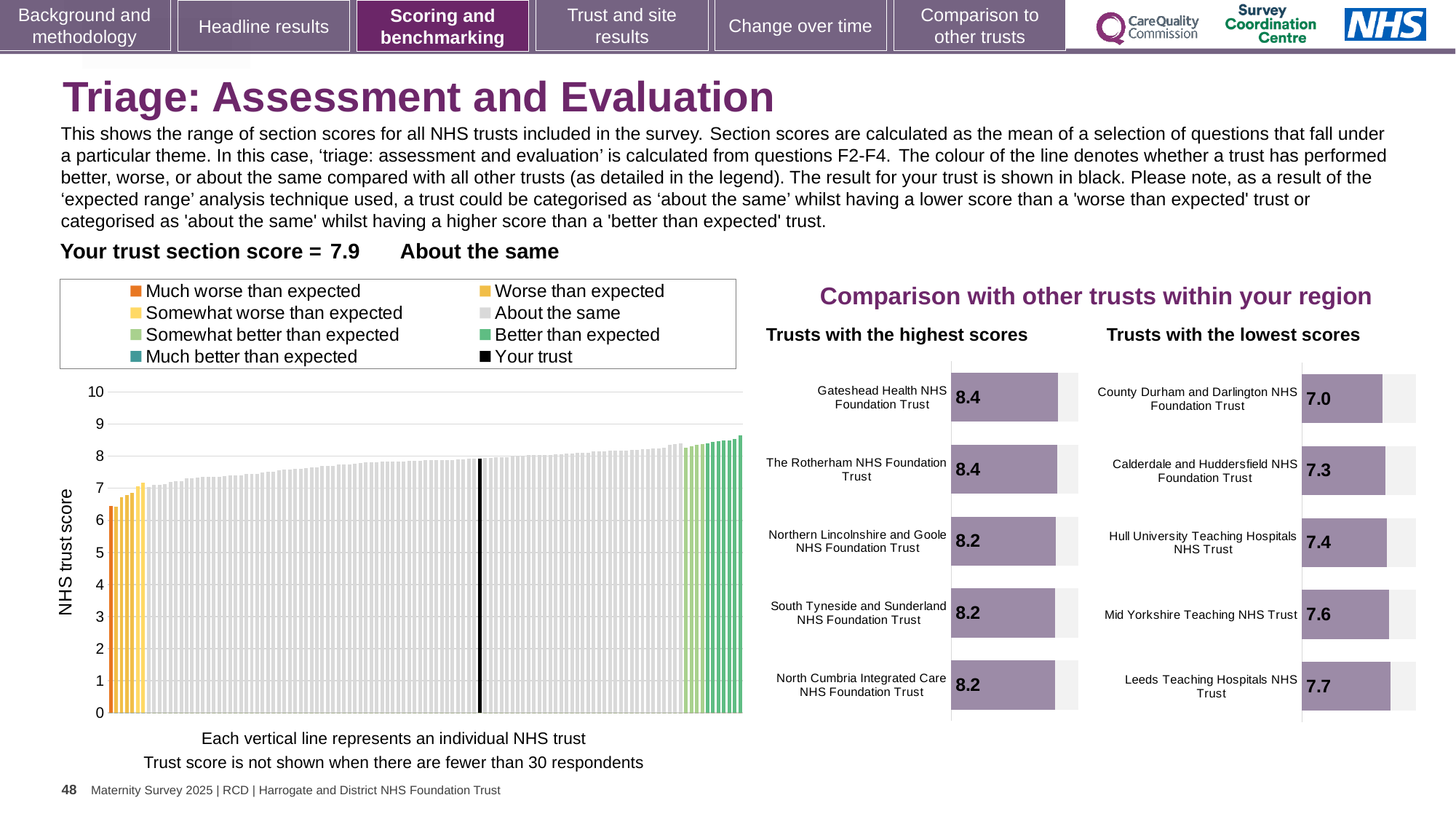
In the 'Trusts with the highest scores' chart, what is the score for Gateshead Health NHS Foundation Trust? 8.4 In the 'Trusts with the highest scores' chart, what is the difference between the scores of Gateshead Health NHS Foundation Trust and Northern Lincolnshire and Goole NHS Foundation Trust? 0.2 In the 'NHS trust score' chart on the left, do the values rise or fall from left to right? Rise What kind of chart is the 'NHS trust score' chart on the left of the slide? Bar chart In the 'Trusts with the lowest scores' chart, what is the score for Calderdale and Huddersfield NHS Foundation Trust? 7.3 In the 'Trusts with the lowest scores' chart, which trust has the lowest score? County Durham and Darlington NHS Foundation Trust In the 'Trusts with the lowest scores' chart, which has the higher score: Hull University Teaching Hospitals NHS Trust or Mid Yorkshire Teaching NHS Trust? Mid Yorkshire Teaching NHS Trust In the 'Trusts with the lowest scores' chart, what is the difference between the scores of Leeds Teaching Hospitals NHS Trust and County Durham and Darlington NHS Foundation Trust? 0.7 How many trusts are listed in the 'Trusts with the highest scores' chart? 5 How many entries does the legend of the 'NHS trust score' chart on the left list? 8 In the 'Trusts with the highest scores' chart, what is the score for South Tyneside and Sunderland NHS Foundation Trust? 8.2 In the 'Trusts with the lowest scores' chart, which trust has the highest score? Leeds Teaching Hospitals NHS Trust